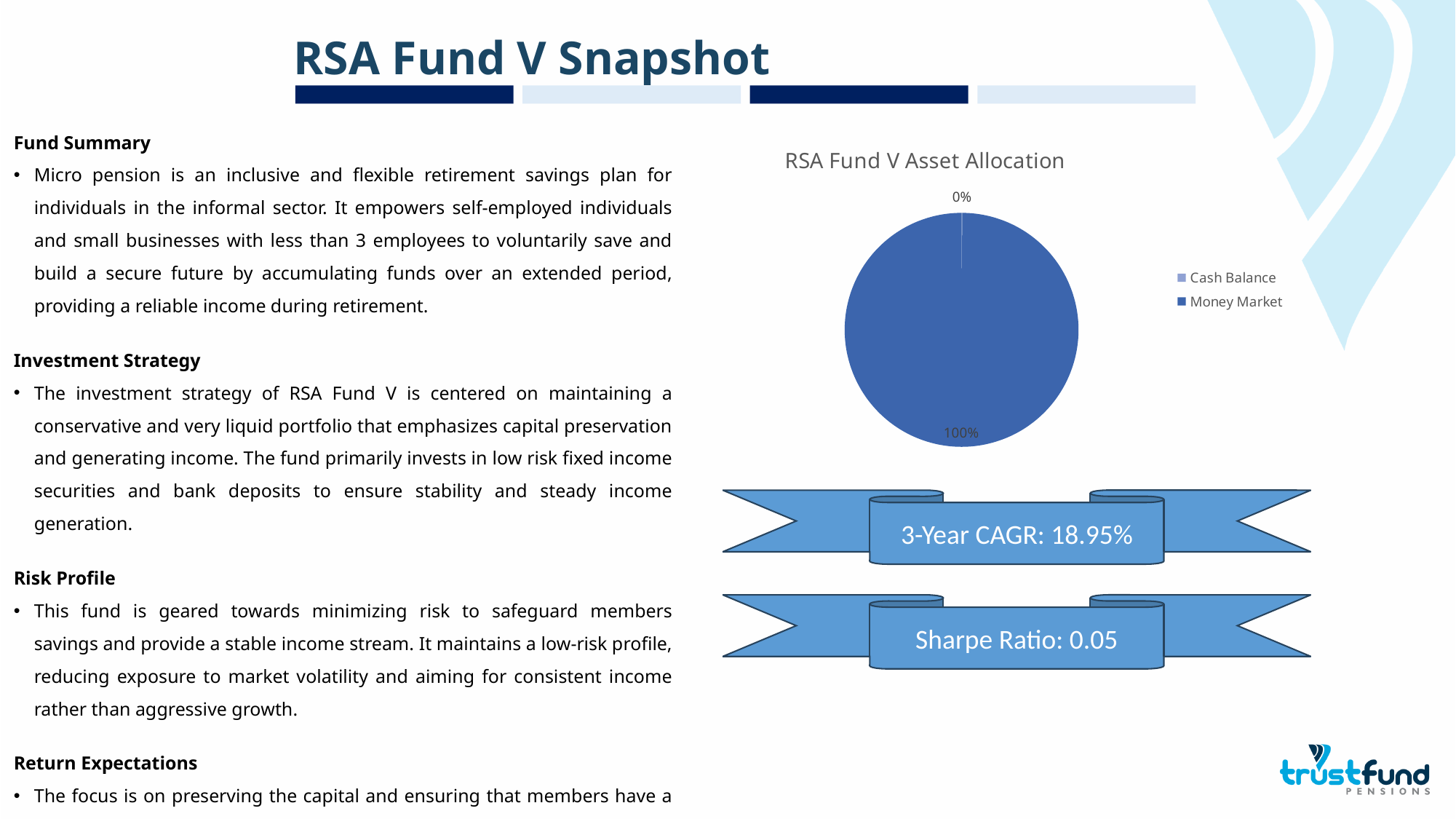
Which category has the smallest share of the pie? Cash Balance How many entries does the chart legend list? 2 What share of the pie does Cash Balance represent? 0% What kind of chart is shown on the slide? pie chart Which is larger, the share for Money Market or the share for Cash Balance? Money Market What share of the pie does Money Market represent? 100% What is the title of the chart? RSA Fund V Asset Allocation Which legend entry is shown in the darker blue colour? Money Market What is the difference between the Money Market share and the Cash Balance share? 100% Which category has the largest share of the pie? Money Market